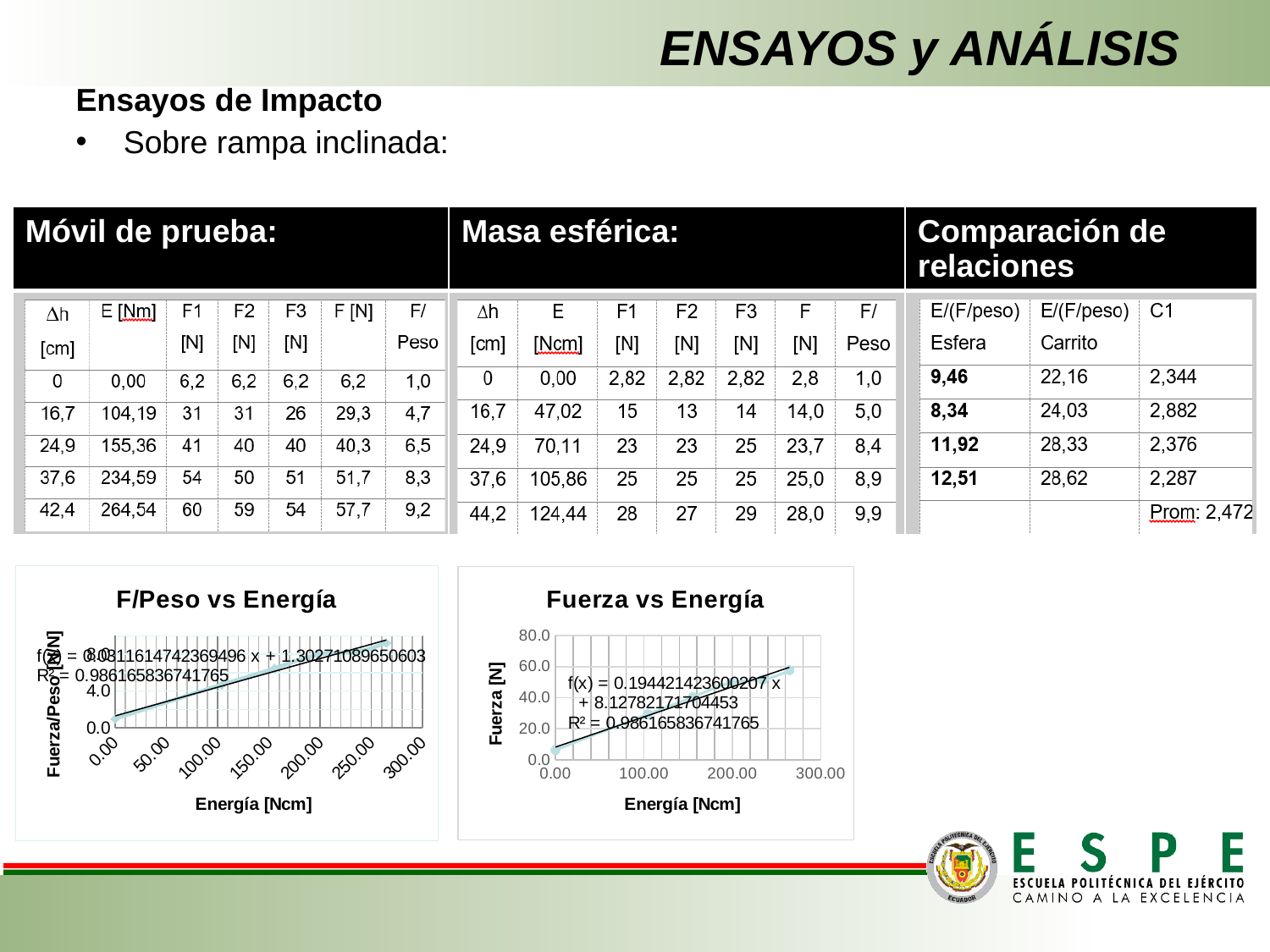
What R² value is shown on the 'Fuerza vs Energía' chart? 0.986165836741765 In the 'Fuerza vs Energía' chart, is the Fuerza value of the rightmost point (near Energía 265) greater or less than 40.0? greater In the 'F/Peso vs Energía' chart, is the value of the point at Energía 0.00 greater or less than 4.0? less What is the x-axis title of the 'Fuerza vs Energía' chart? Energía [Ncm] What kind of chart is the 'F/Peso vs Energía' chart? scatter chart In the 'F/Peso vs Energía' chart, do the plotted values rise or fall as Energía increases? rise In the 'Fuerza vs Energía' chart, do the plotted values rise or fall as Energía increases? rise What kind of chart is the 'Fuerza vs Energía' chart? scatter chart In the 'Fuerza vs Energía' chart, is the Fuerza value of the point at Energía 0.00 greater or less than 20.0? less